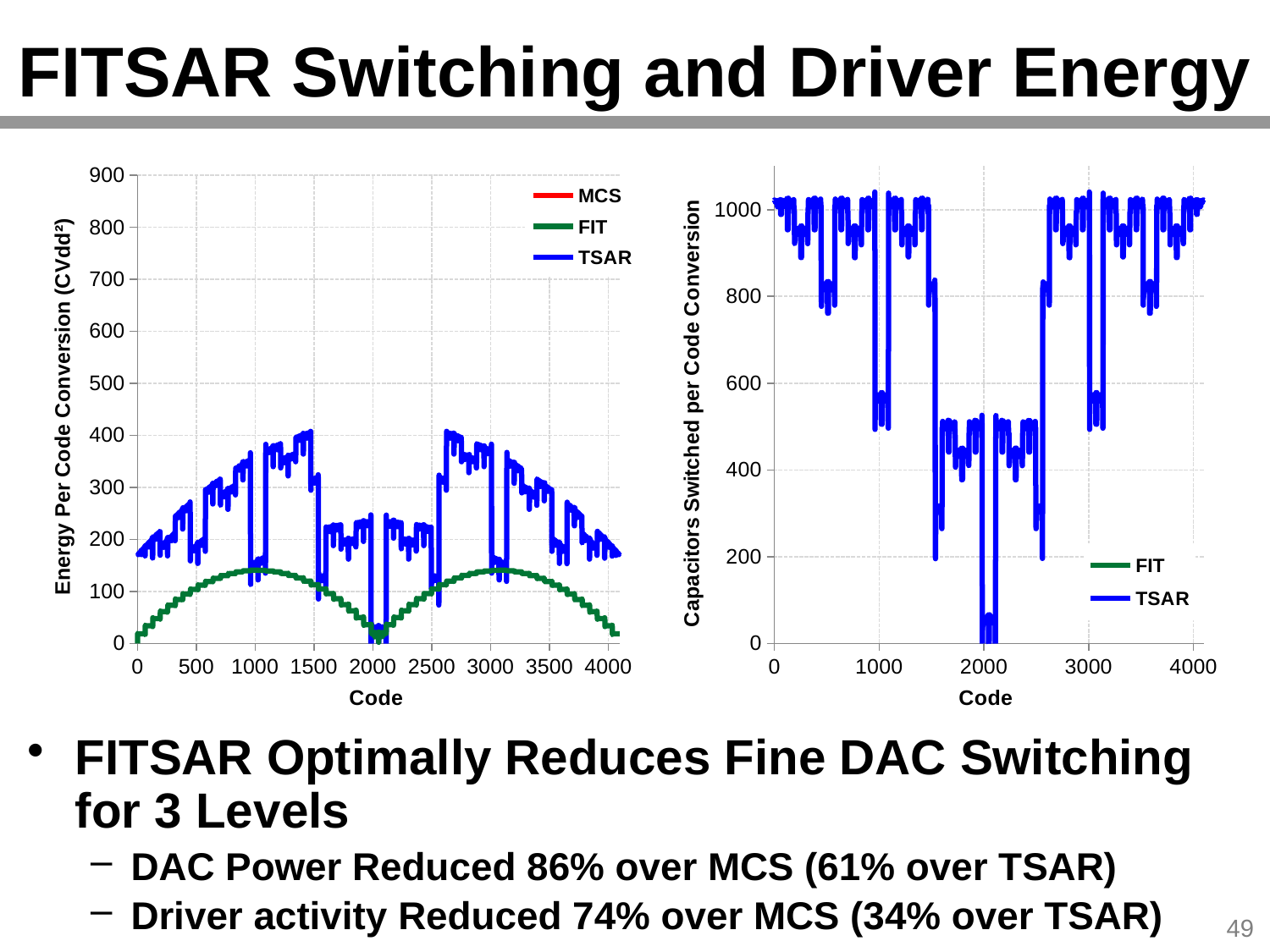
In the right chart, is the TSAR value at code 0 greater or less than 800? greater In the right chart, is the TSAR value near code 2000 greater or less than 200? less What is the y-axis label of the left chart? Energy Per Code Conversion (CVdd²) What is the y-axis label of the right chart? Capacitors Switched per Code Conversion How many series does the legend of the left chart list? 3 What kind of chart is the right chart? Line chart What kind of chart is the left chart? Line chart In the left chart, is the highest value of the TSAR series greater or less than 300? greater In the left chart, does the FIT series rise or fall between code 0 and code 1000? rise How many series does the legend of the right chart list? 2 In the left chart, which series is higher at code 1500, FIT or TSAR? TSAR